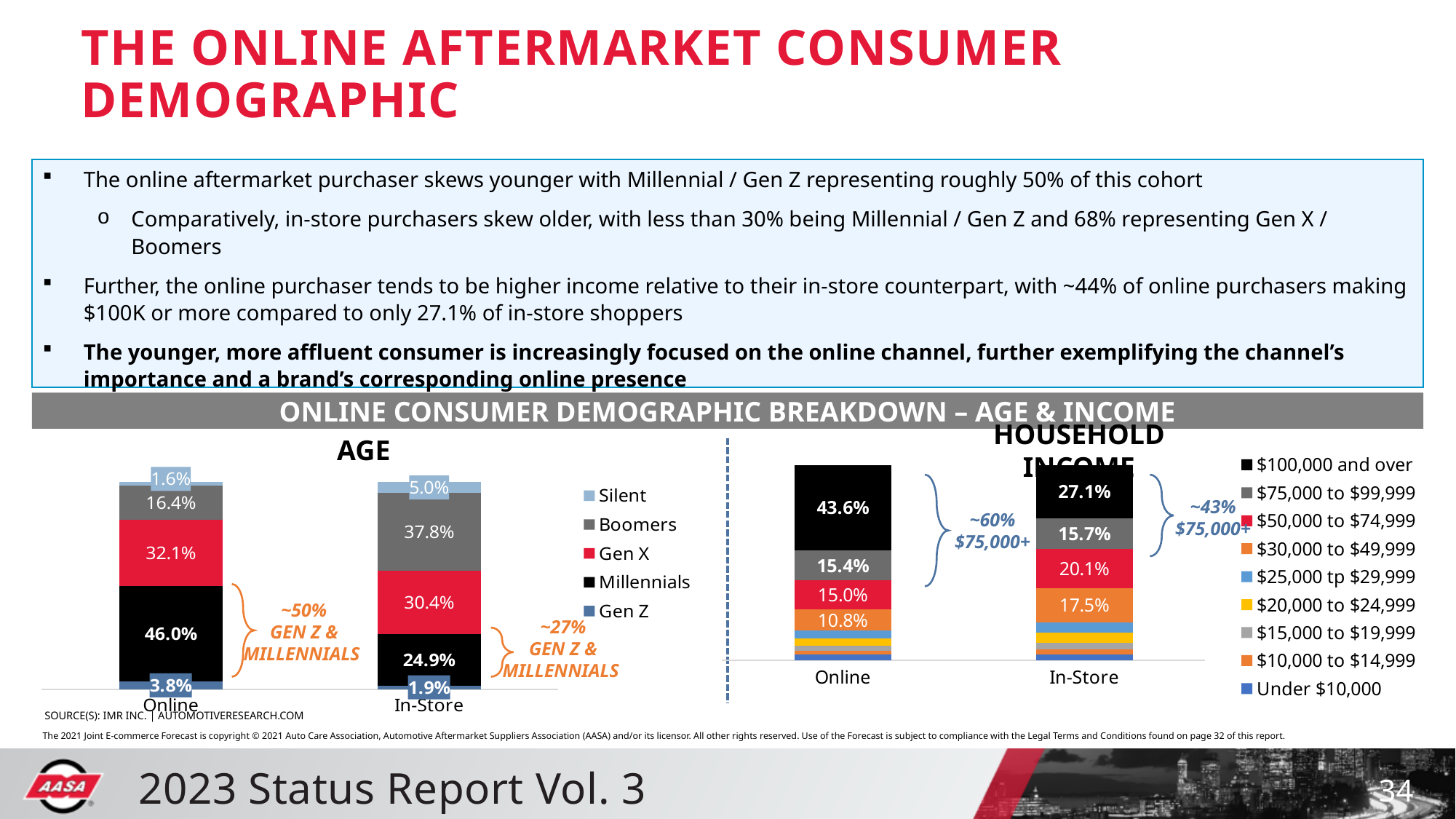
In the AGE chart, what is the difference between the Millennials share for Online and for In-Store? 21.1% In the HOUSEHOLD INCOME chart, what is the difference between the $100,000 and over share for Online and for In-Store? 16.5% In the AGE chart, is the Gen X share larger for Online or for In-Store? Online In the AGE chart, what percentage of Online purchasers are Millennials? 46.0% In the HOUSEHOLD INCOME chart, what percentage of Online purchasers earn $100,000 and over? 43.6% In the AGE chart, what percentage of In-Store purchasers are Boomers? 37.8% What kind of chart is the HOUSEHOLD INCOME chart? Stacked bar chart In the AGE chart, which age group is the largest segment of the In-Store bar? Boomers How many series does the legend of the AGE chart list? 5 How many series does the legend of the HOUSEHOLD INCOME chart list? 9 In the HOUSEHOLD INCOME chart, what percentage of In-Store purchasers earn $50,000 to $74,999? 20.1% In the AGE chart, which age group is the smallest segment of the Online bar? Silent